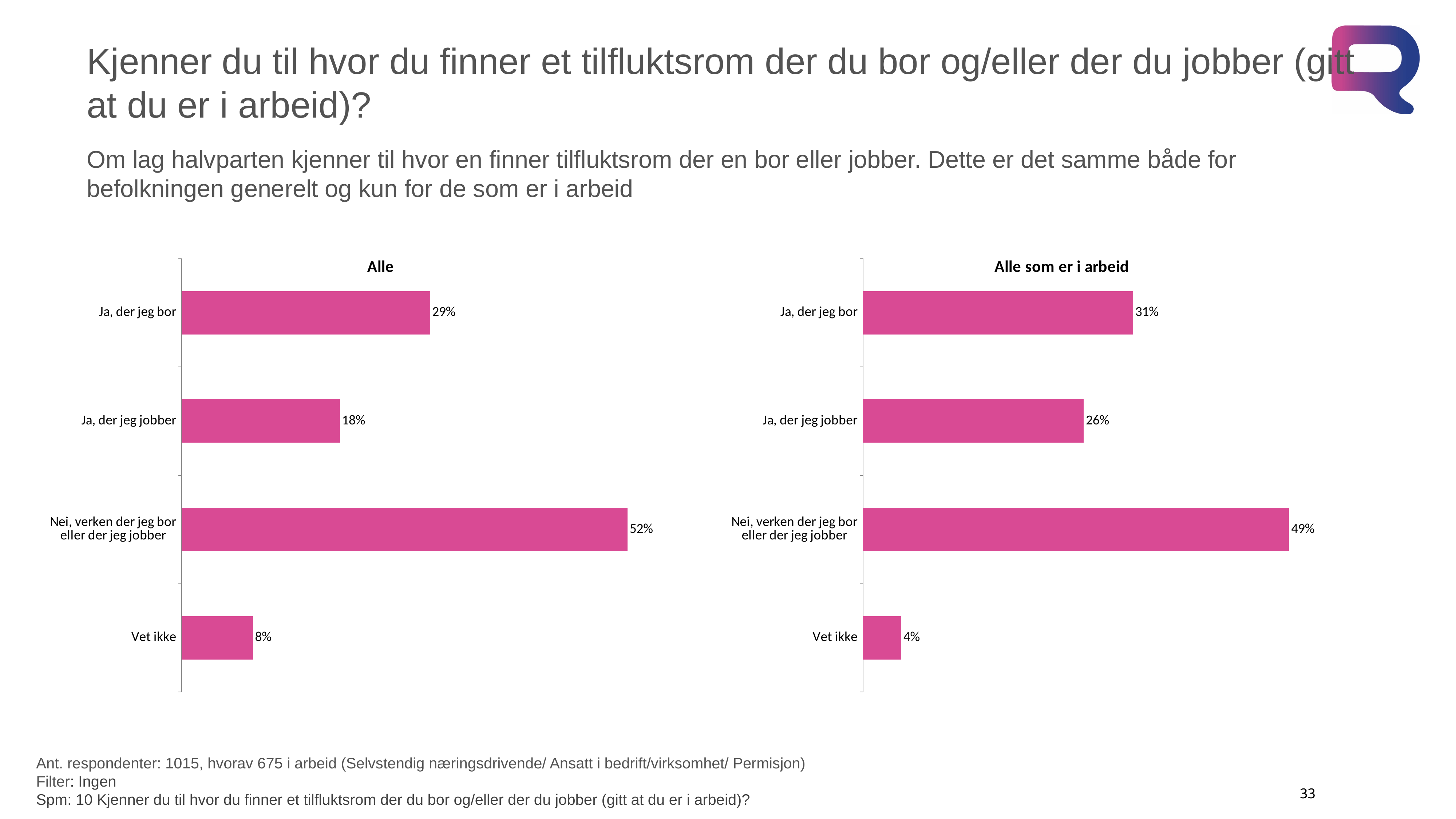
In the "Alle som er i arbeid" chart, what is the value for "Ja, der jeg jobber"? 26% In the "Alle" chart, what is the value for "Ja, der jeg bor"? 29% In the "Alle" chart, how many categories are shown? 4 Which chart has the larger value for "Ja, der jeg jobber", "Alle" or "Alle som er i arbeid"? Alle som er i arbeid What is the title of the chart on the right side of the slide? Alle som er i arbeid In the "Alle som er i arbeid" chart, what is the difference between "Ja, der jeg bor" and "Ja, der jeg jobber"? 5% In the "Alle som er i arbeid" chart, what is the value for "Vet ikke"? 4% In the "Alle" chart, which category has the lowest value? Vet ikke In the "Alle som er i arbeid" chart, which category has the highest value? Nei, verken der jeg bor eller der jeg jobber In the "Alle" chart, what is the value for "Vet ikke"? 8% In the "Alle" chart, what is the difference between "Nei, verken der jeg bor eller der jeg jobber" and "Ja, der jeg bor"? 23% What kind of chart is the "Alle som er i arbeid" chart? Bar chart